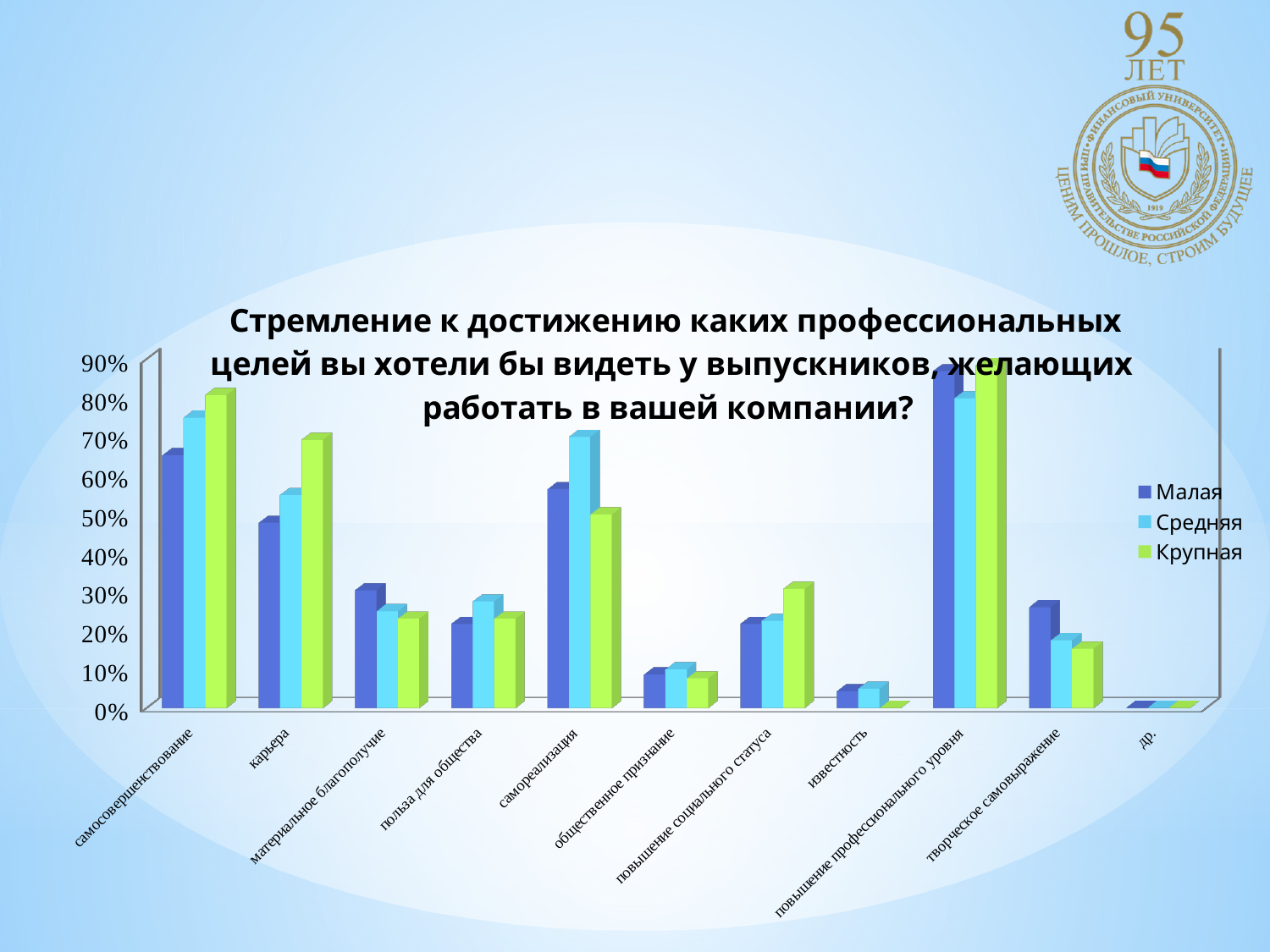
Is the value for Малая in the category материальное благополучие greater or less than 20%? greater How many categories are shown along the x axis? 11 In the category самореализация, which is larger: the value for Средняя or the value for Крупная? Средняя Is the value for Крупная in the category карьера greater or less than 60%? greater For the Крупная series, which category has the highest value? повышение профессионального уровня Is the value for Средняя in the category самореализация greater or less than 60%? greater Which series are listed in the legend? Малая, Средняя, Крупная How many series does the legend list? 3 What kind of chart is shown on the slide? bar chart In the category карьера, which is larger: the value for Крупная or the value for Малая? Крупная